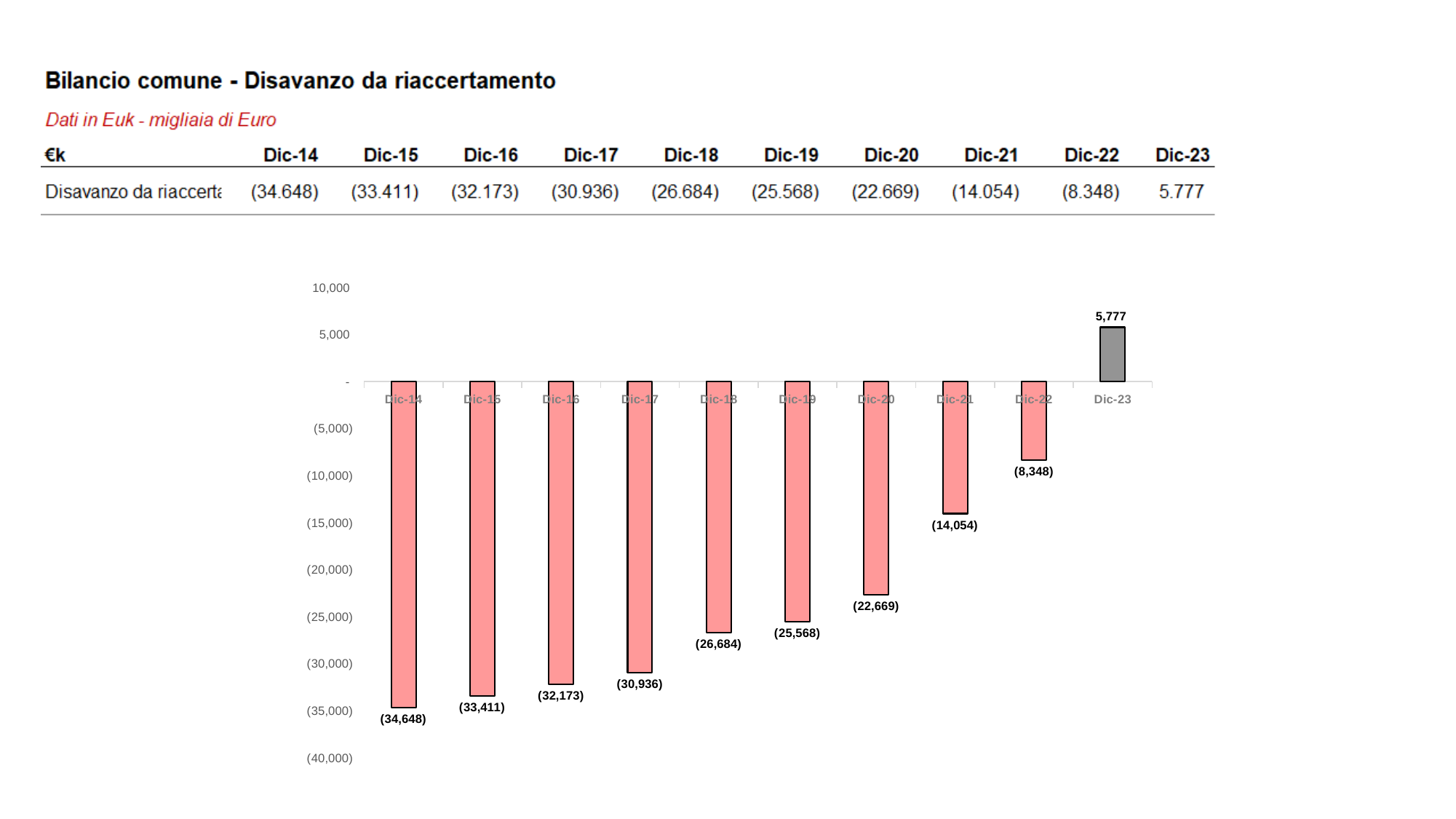
What is the value shown for Dic-20 in the chart? (22,669) How many periods are plotted in the chart? 10 Which is larger, the value for Dic-18 or the value for Dic-19? Dic-19 Which period has the highest value in the chart? Dic-23 Do the values rise or fall from Dic-14 to Dic-23? Rise What kind of chart is shown on the slide? Bar chart What is the value shown for Dic-14 in the chart? (34,648) Which period has the lowest value in the chart? Dic-14 What is the difference between the values for Dic-21 and Dic-22? 5,706 What is the value shown for Dic-23 in the chart? 5,777 What is the difference between the values for Dic-14 and Dic-15? 1,237 Is the value for Dic-22 greater or less than (10,000)? greater